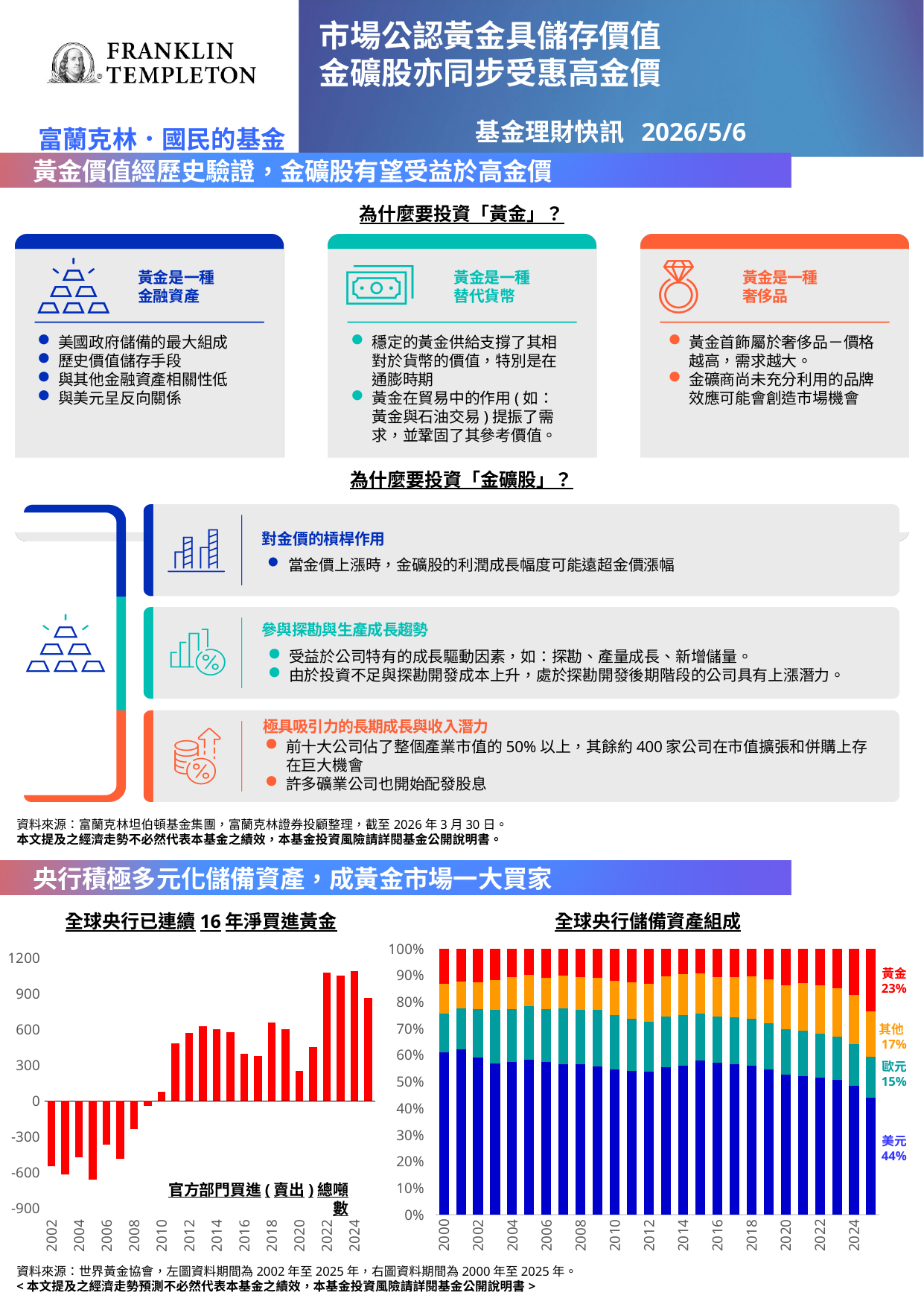
How many series (reserve asset components) are shown in the right chart 全球央行儲備資產組成? 4 In the right chart 全球央行儲備資產組成, which component has the smallest share in the latest year? 歐元 In the right chart 全球央行儲備資產組成, what share does 其他 have in the latest year? 17% What kind of chart is the right chart titled 全球央行儲備資產組成? stacked bar chart In the right chart 全球央行儲備資產組成, which component has the largest share in the latest year? 美元 In the right chart 全球央行儲備資產組成, what share does 黃金 have in the latest year? 23% In the right chart 全球央行儲備資產組成, what share does 美元 have in the latest year? 44% What kind of chart is the left chart titled 全球央行已連續 16 年淨買進黃金? bar chart In the right chart 全球央行儲備資產組成, does the 美元 share rise or fall from 2000 to 2025? fall In the right chart 全球央行儲備資產組成, what share does 歐元 have in the latest year? 15% In the right chart 全球央行儲備資產組成, how many percentage points larger is the 美元 share than the 黃金 share in the latest year? 21 In the left chart 全球央行已連續 16 年淨買進黃金, is the value for 2022 greater or less than 900? greater